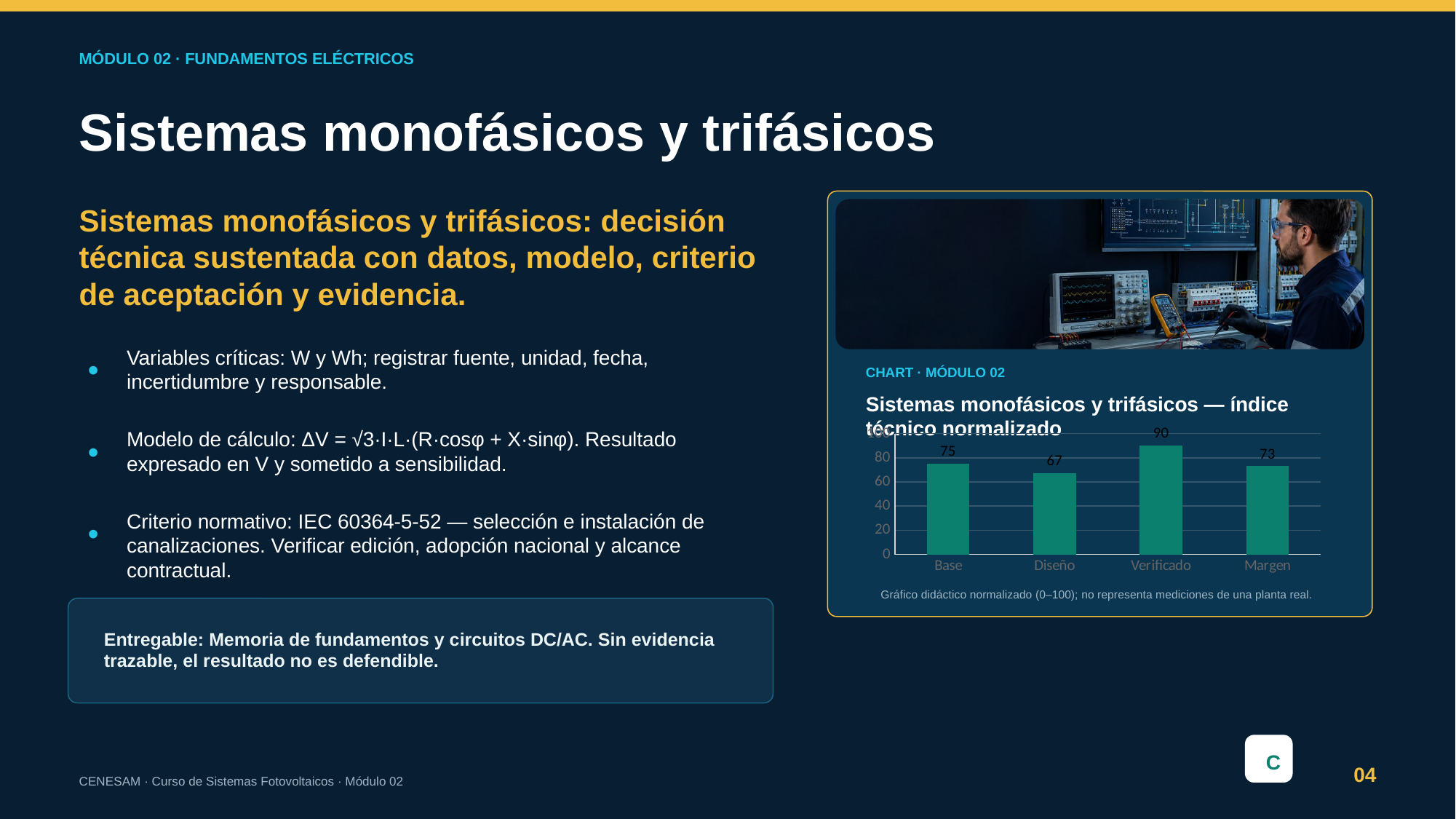
Which category has the lowest value? Diseño What is the value for Diseño? 67 What kind of chart is shown? bar chart What is the value for Base? 75 How many categories are shown on the x axis? 4 What is the difference between the values for Verificado and Diseño? 23 What is the value for Margen? 73 What is the title of the chart? Sistemas monofásicos y trifásicos — índice técnico normalizado Is the value for Diseño greater or less than 80? less Which category has the highest value? Verificado Which is larger, the value for Base or the value for Margen? Base What is the value for Verificado? 90